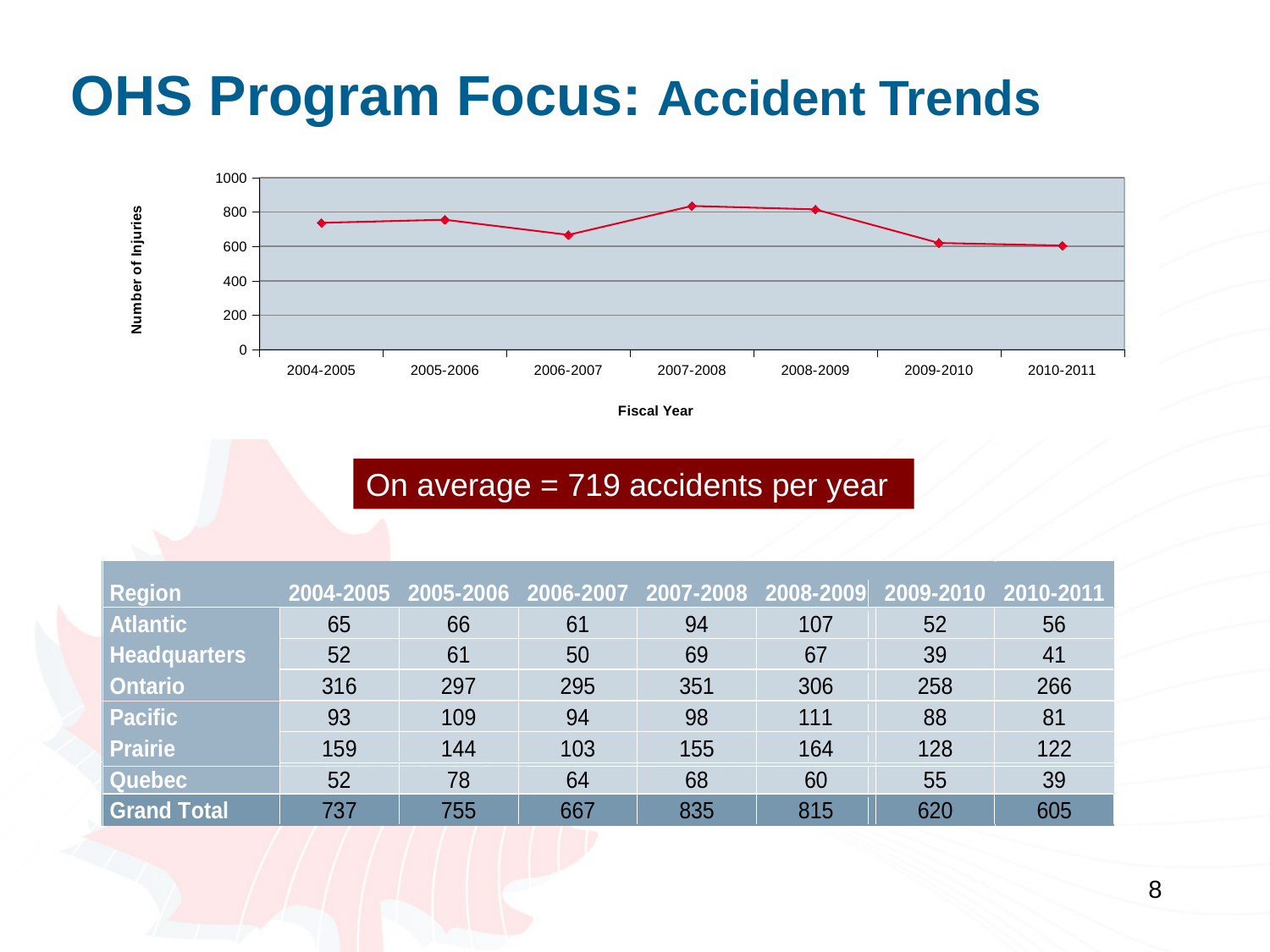
According to the Grand Total row on the slide, what is the difference in injuries between 2007-2008 and 2010-2011? 230 Which has more injuries in the chart, 2005-2006 or 2006-2007? 2005-2006 Is the number of injuries for 2006-2007 greater or less than 800? less Which fiscal year has the lowest number of injuries in the chart? 2010-2011 According to the Grand Total row on the slide, what is the number of injuries plotted for 2007-2008? 835 Do the number of injuries rise or fall from 2008-2009 to 2010-2011? fall What is the label of the y axis of the chart? Number of Injuries Is the number of injuries for 2007-2008 greater or less than 800? greater What kind of chart is shown on the slide? line chart How many fiscal years are plotted on the x axis of the chart? 7 Which fiscal year has the highest number of injuries in the chart? 2007-2008 Is the number of injuries for 2009-2010 greater or less than 800? less